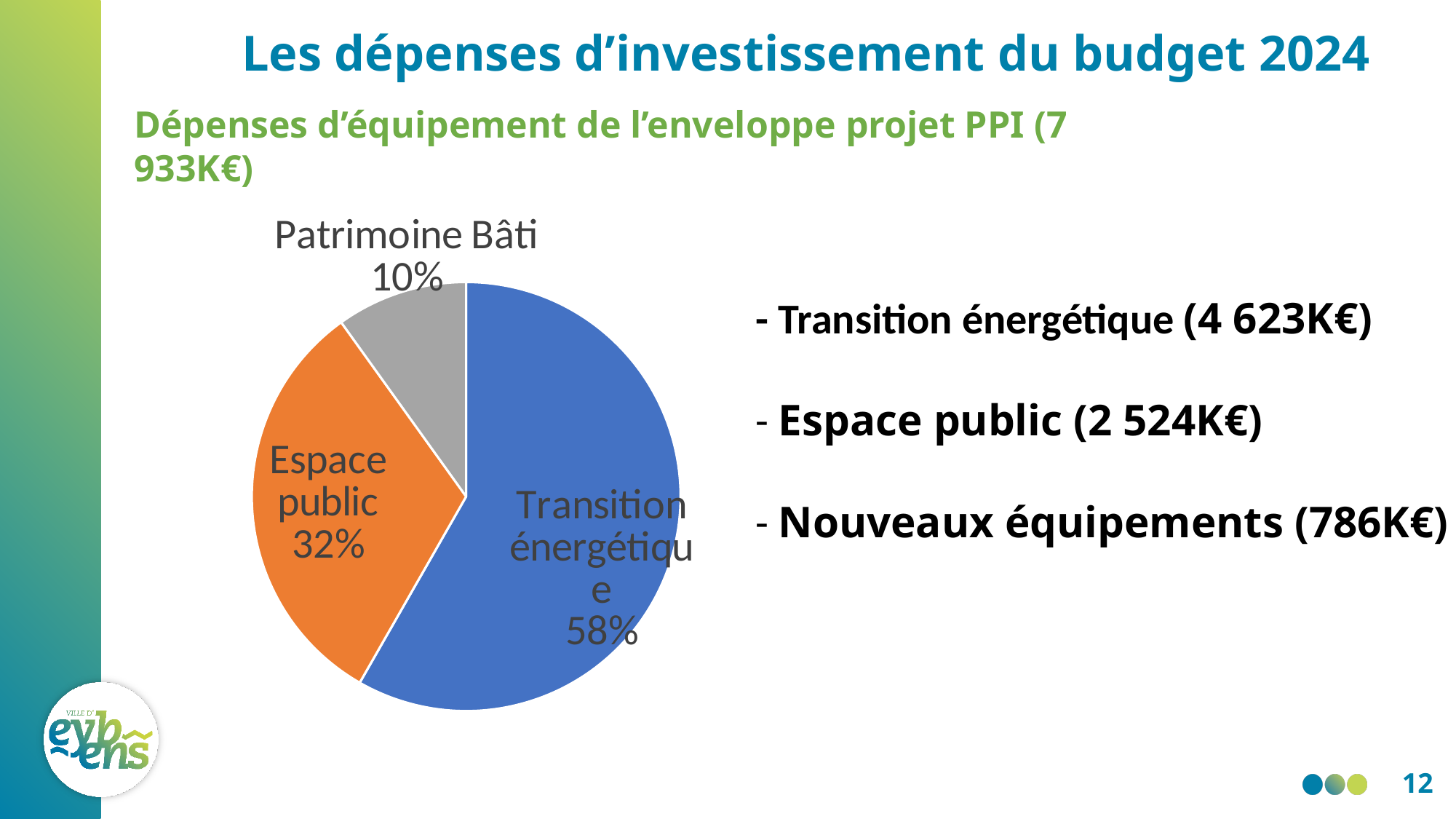
What colour is the Espace public slice? orange What share of the pie does Espace public represent? 32% What is the difference in percentage points between the Transition énergétique and Espace public slices? 26 What colour is the Transition énergétique slice? blue Which slice of the pie chart is the smallest? Patrimoine Bâti What share of the pie does Patrimoine Bâti represent? 10% What share of the pie does Transition énergétique represent? 58% What kind of chart is shown on the slide? pie chart Which is larger, the Espace public slice or the Patrimoine Bâti slice? Espace public Which slice of the pie chart is the largest? Transition énergétique What is the difference in percentage points between the Espace public and Patrimoine Bâti slices? 22 How many slices does the pie chart have? 3